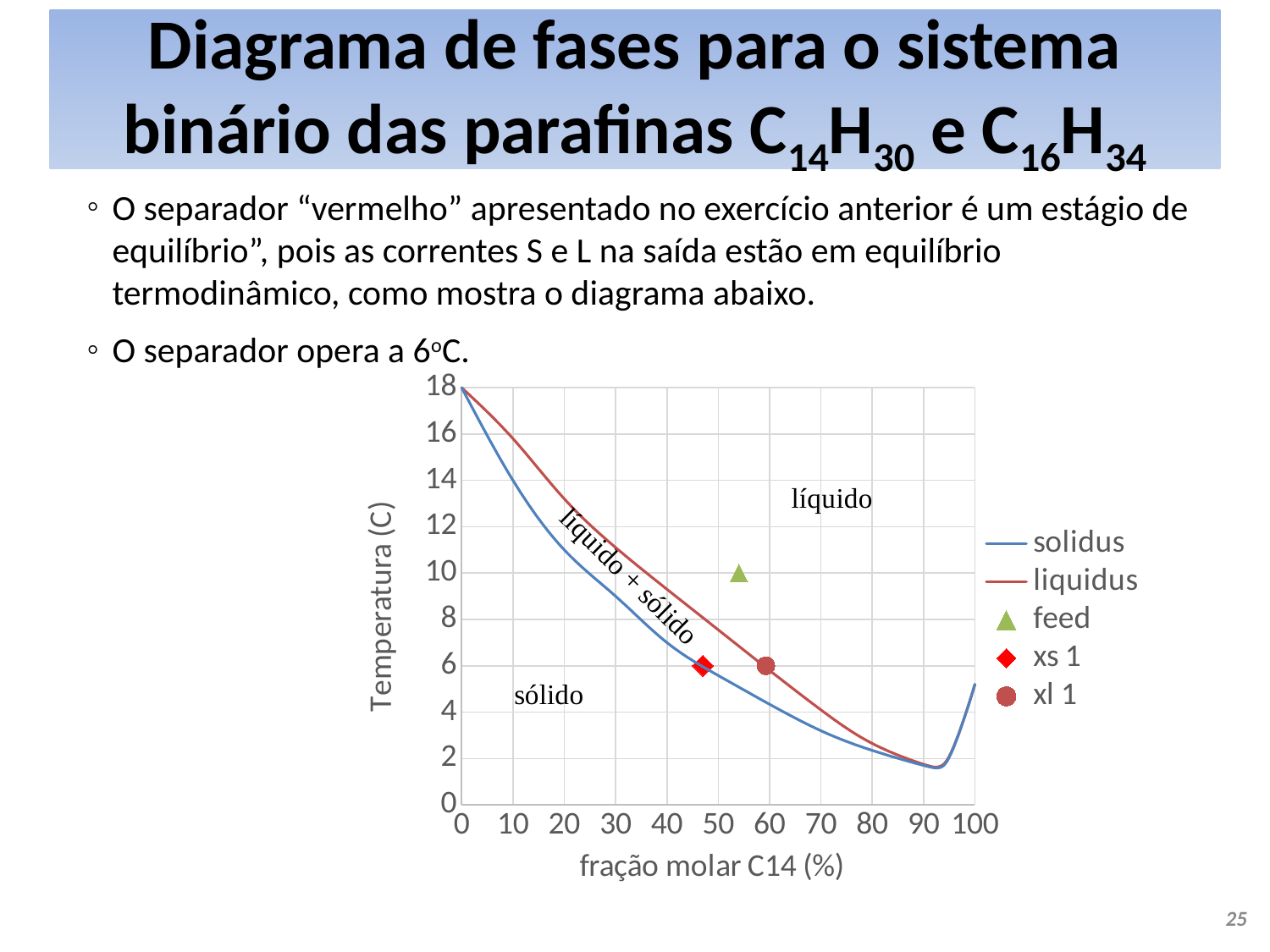
At what temperature do the solidus and liquidus curves start at a C14 molar fraction of 0? 18 What kind of chart is shown on the slide? line chart Is the C14 molar fraction of the xs 1 point greater or less than 50? less At what temperature is the xs 1 point plotted? 6 How many series does the chart legend list? 5 At a C14 molar fraction of 50, which curve is at the higher temperature, solidus or liquidus? liquidus What is the title of the x axis of the chart? fração molar C14 (%) Which point has the higher C14 molar fraction, xs 1 or xl 1? xl 1 What is the title of the y axis of the chart? Temperatura (C) Does the liquidus curve rise or fall as the C14 molar fraction increases from 0 to 90? fall At what temperature is the feed point plotted? 10 Is the C14 molar fraction of the feed point greater or less than 50? greater